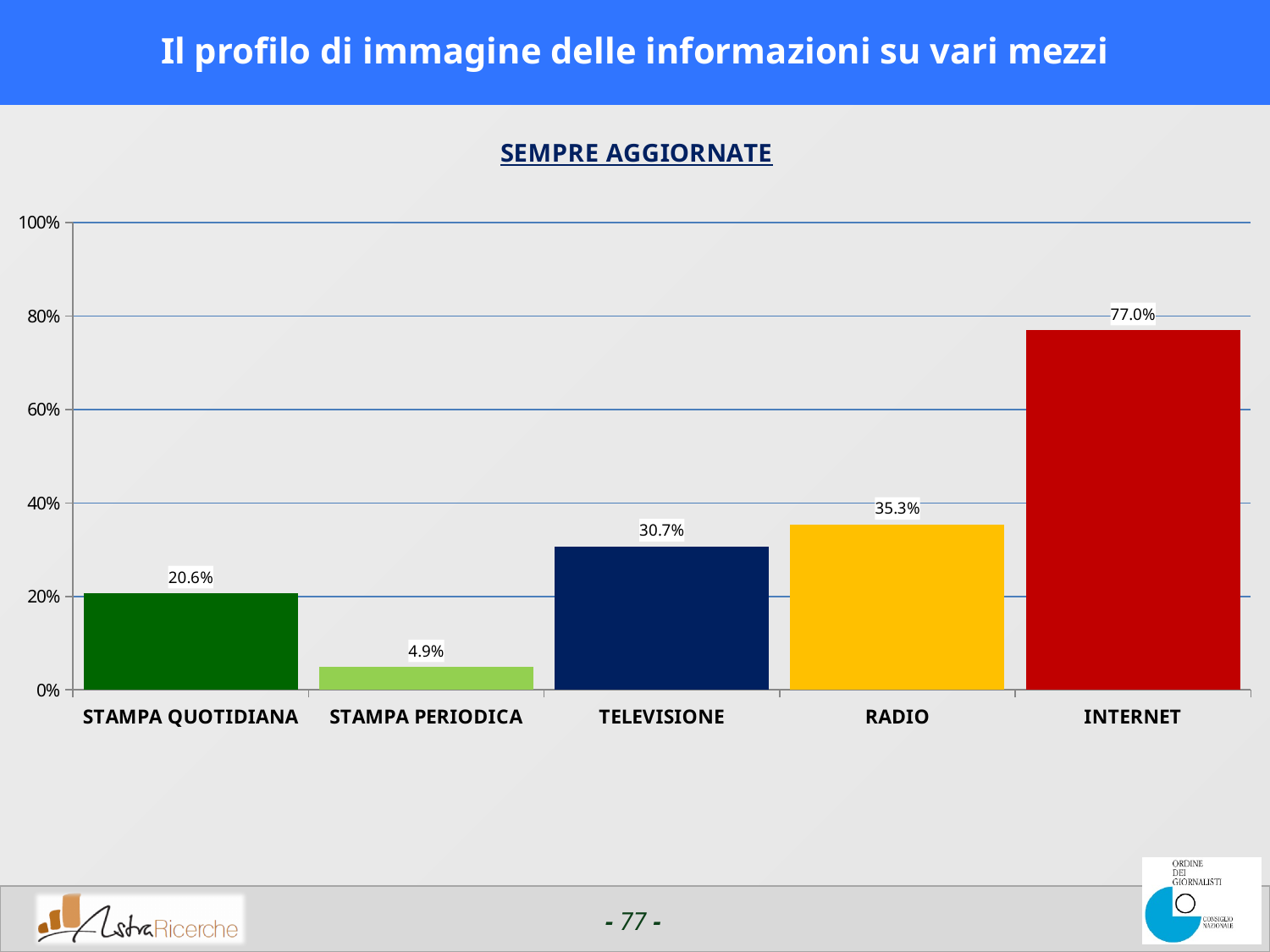
How many categories are shown on the x axis? 5 Which category has the lowest value? STAMPA PERIODICA Is the value for STAMPA QUOTIDIANA greater or less than 40%? less What is the title shown above the chart? SEMPRE AGGIORNATE Which category has the highest value? INTERNET What is the value for TELEVISIONE? 30.7% Which is larger, the value for RADIO or the value for TELEVISIONE? RADIO What is the difference between the values for STAMPA QUOTIDIANA and STAMPA PERIODICA? 15.7% What is the value for INTERNET? 77.0% What is the value for STAMPA PERIODICA? 4.9% What is the difference between the values for INTERNET and RADIO? 41.7% What kind of chart is shown on the slide? bar chart